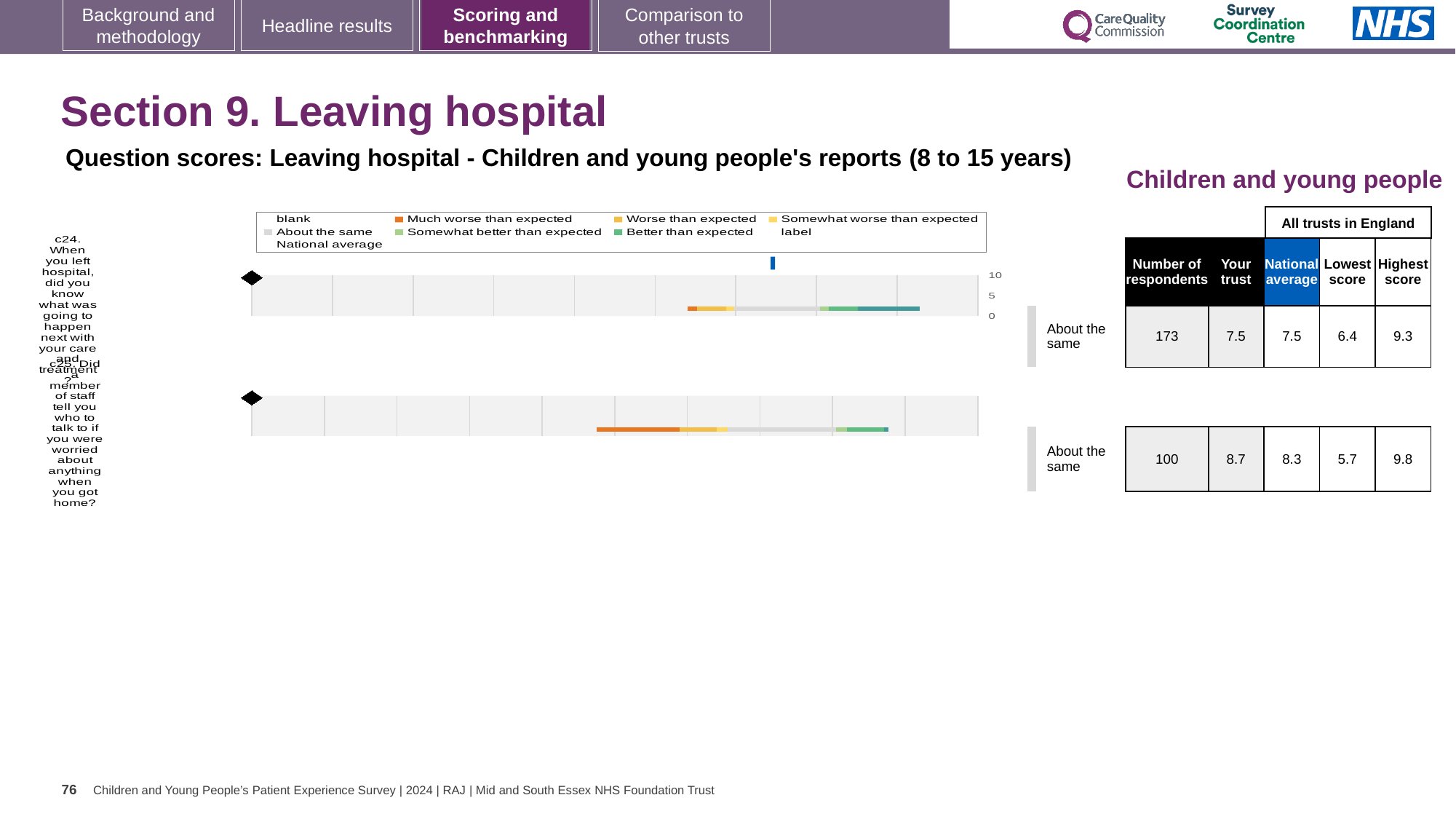
How many survey questions (bars) are plotted in the chart? 2 In the table beside the chart, what is the 'Your trust' score for question c25? 8.7 In the table beside the chart, what is the 'Your trust' score for question c24? 7.5 Which question has the higher 'Your trust' score in the table, c24 or c25? c25 Which legend entry is shown in orange in the chart? Much worse than expected In the table beside the chart, how many respondents answered question c24? 173 What is the difference between the 'Your trust' score and the national average for question c25 in the table? 0.4 What benchmark category is shown next to the bar for question c24? About the same In the table beside the chart, what is the highest score among all trusts in England for question c25? 9.8 In the table beside the chart, what is the national average for question c25? 8.3 What is the title of the chart section shown on the slide? Question scores: Leaving hospital - Children and young people's reports (8 to 15 years) What kind of chart is shown on the slide? bar chart